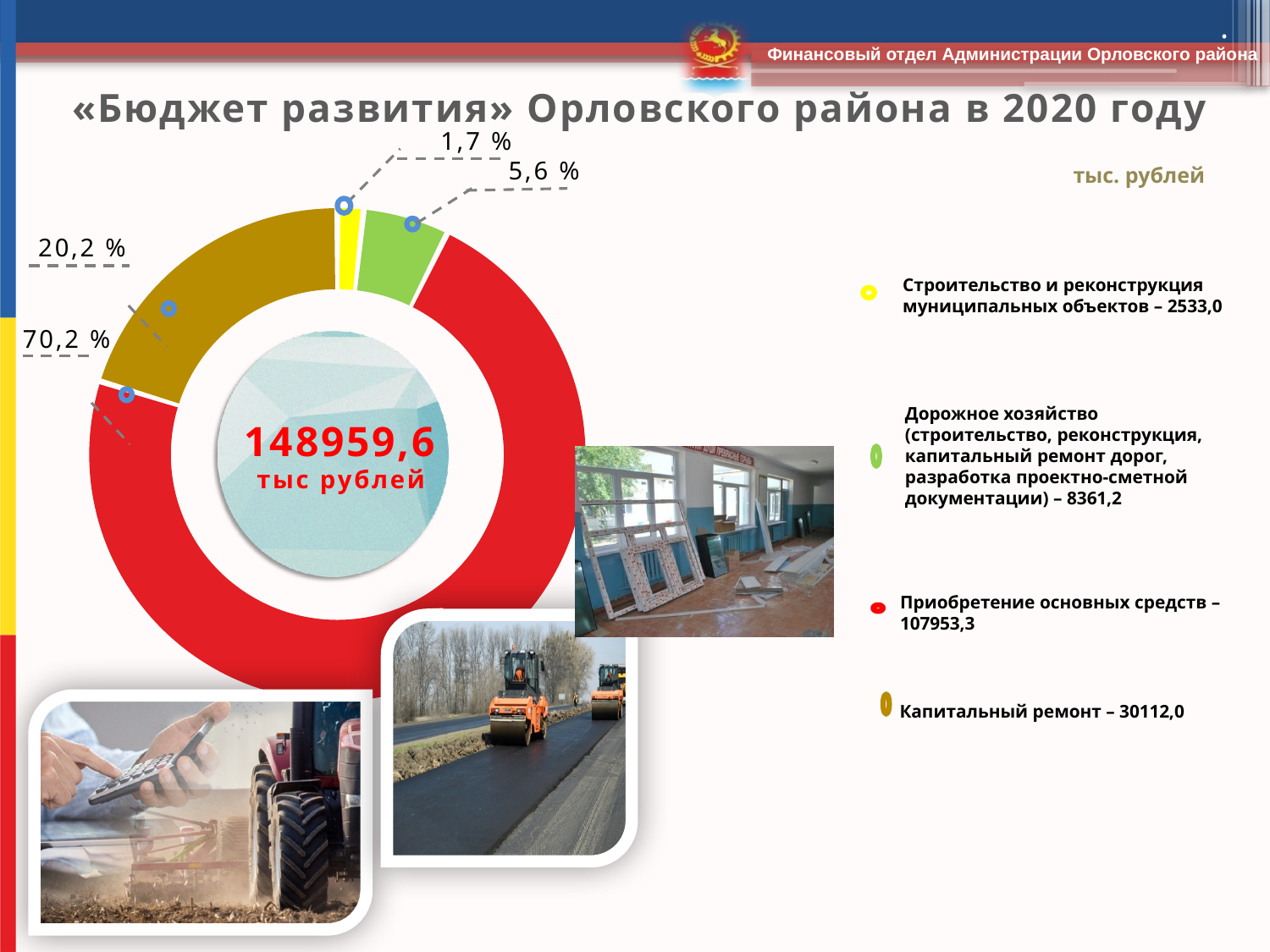
Which category has the largest share of the doughnut chart? Приобретение основных средств What total value is shown in the centre of the doughnut chart? 148959,6 тыс рублей Which category has the smallest share of the doughnut chart? Строительство и реконструкция муниципальных объектов What percentage share does the slice for Капитальный ремонт have? 20,2 % What kind of chart is shown on the slide? Doughnut (pie) chart How many categories (slices) does the doughnut chart have? 4 What percentage share does the yellow slice (Строительство и реконструкция муниципальных объектов) have? 1,7 % What is the value (тыс. рублей) for Приобретение основных средств? 107953,3 What percentage share does the green slice (Дорожное хозяйство) have? 5,6 % What is the value (тыс. рублей) for Дорожное хозяйство? 8361,2 What is the difference in percentage points between the shares for Капитальный ремонт and Дорожное хозяйство? 14,6 %